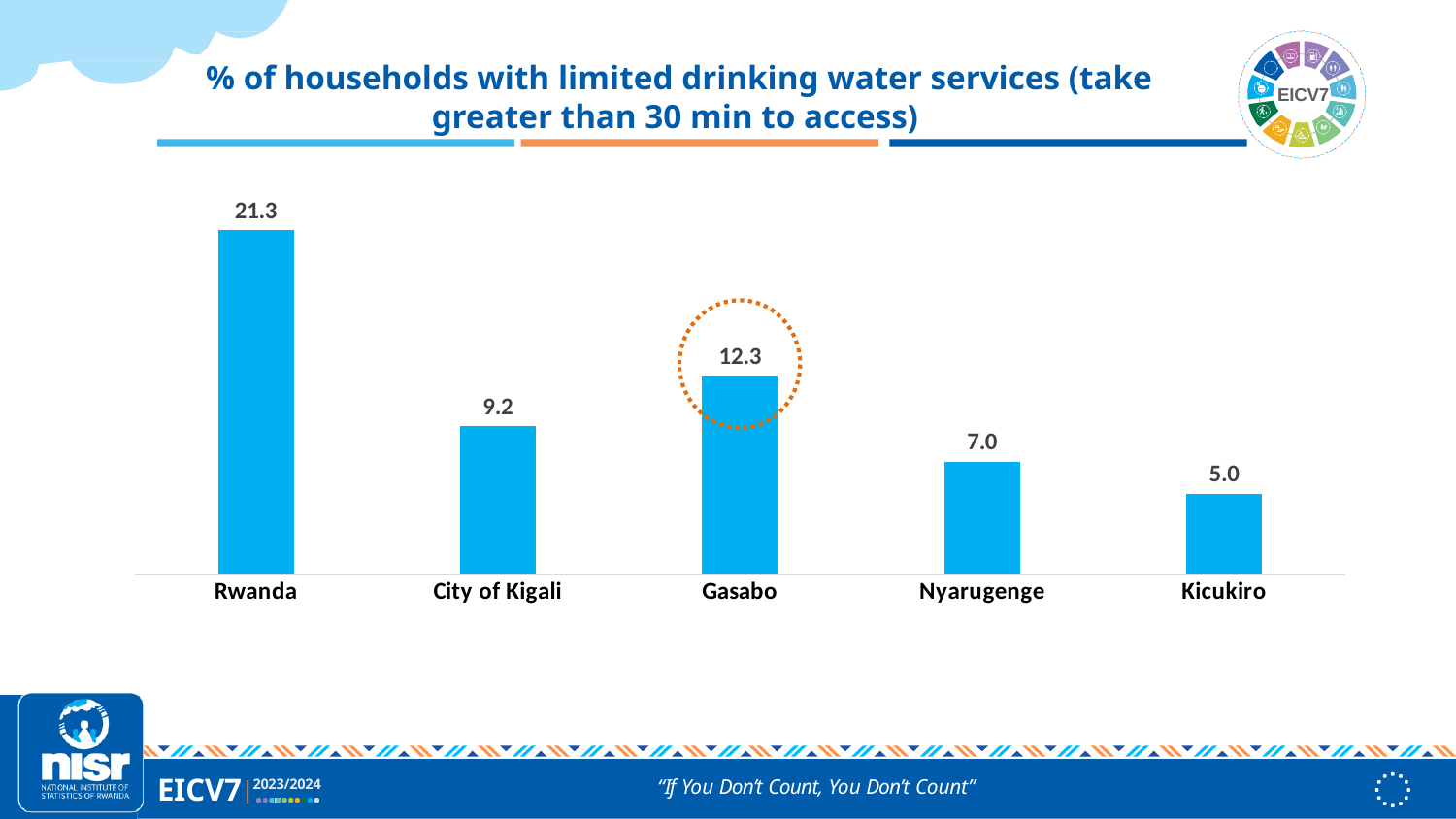
Which category has the highest value? Rwanda What is the value for Gasabo? 12.3 What is the value for Rwanda? 21.3 How many categories are shown in the chart? 5 What is the difference between the values for Rwanda and City of Kigali? 12.1 What is the value for Kicukiro? 5.0 Which category's bar is highlighted with a dotted orange circle? Gasabo What is the value for Nyarugenge? 7.0 Which category has the lowest value? Kicukiro What is the difference between the values for Gasabo and Nyarugenge? 5.3 What kind of chart is shown on the slide? Bar chart Which is larger, the value for Gasabo or the value for City of Kigali? Gasabo